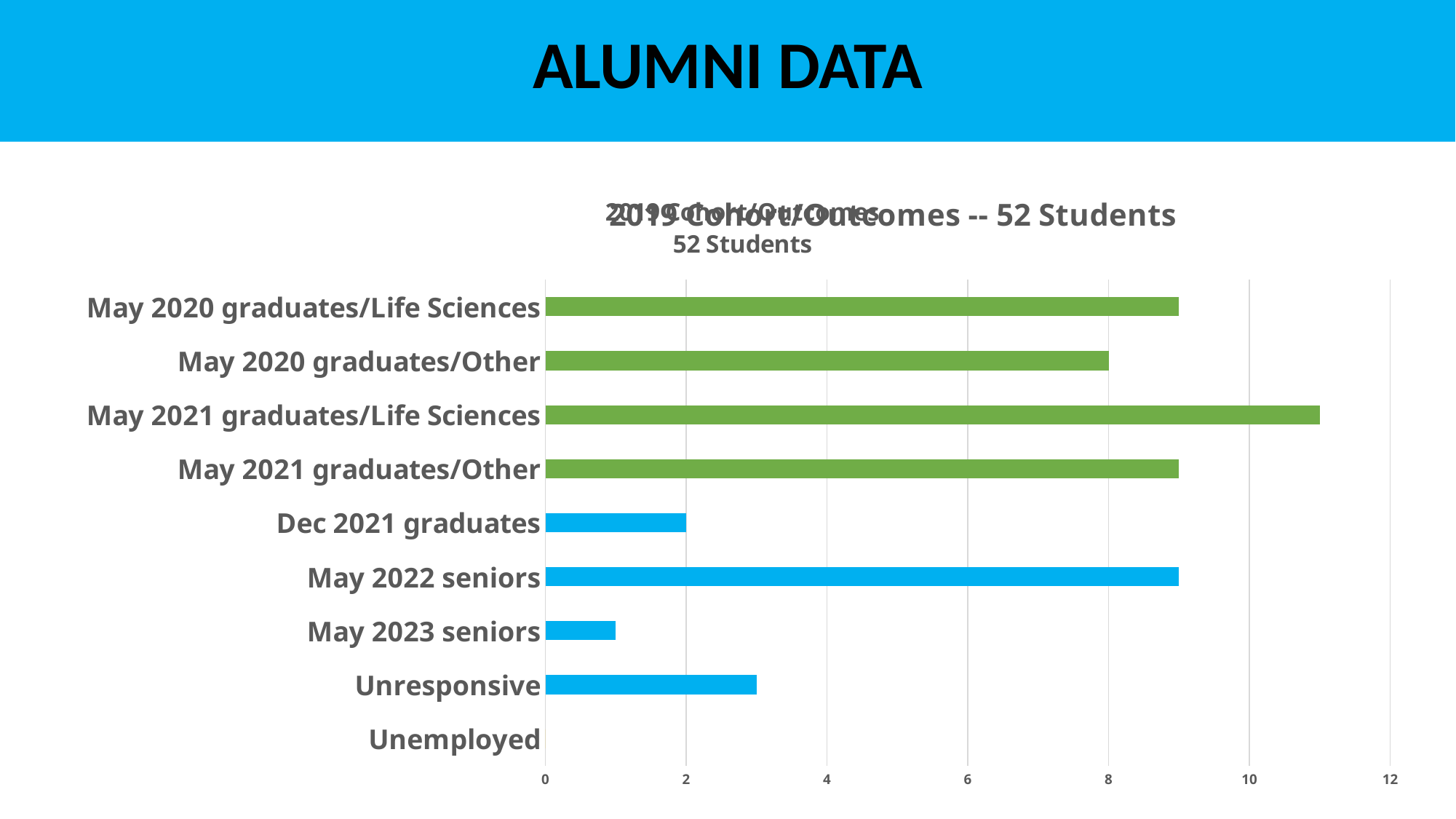
What is the difference between the values for May 2020 graduates/Other and Dec 2021 graduates? 6 What is the value for May 2020 graduates/Other? 8 Which is larger, the value for Unresponsive or the value for Dec 2021 graduates? Unresponsive Is the value for May 2021 graduates/Life Sciences greater or less than 10? greater What is the value for Unemployed? 0 Which category has the highest value? May 2021 graduates/Life Sciences Is the value for May 2023 seniors greater or less than 2? less What is the value for Dec 2021 graduates? 2 Which category has the lowest value? Unemployed What is the title of the chart? 2019 Cohort/Outcomes -- 52 Students What kind of chart is shown on the slide? Bar chart How many categories are shown on the chart? 9